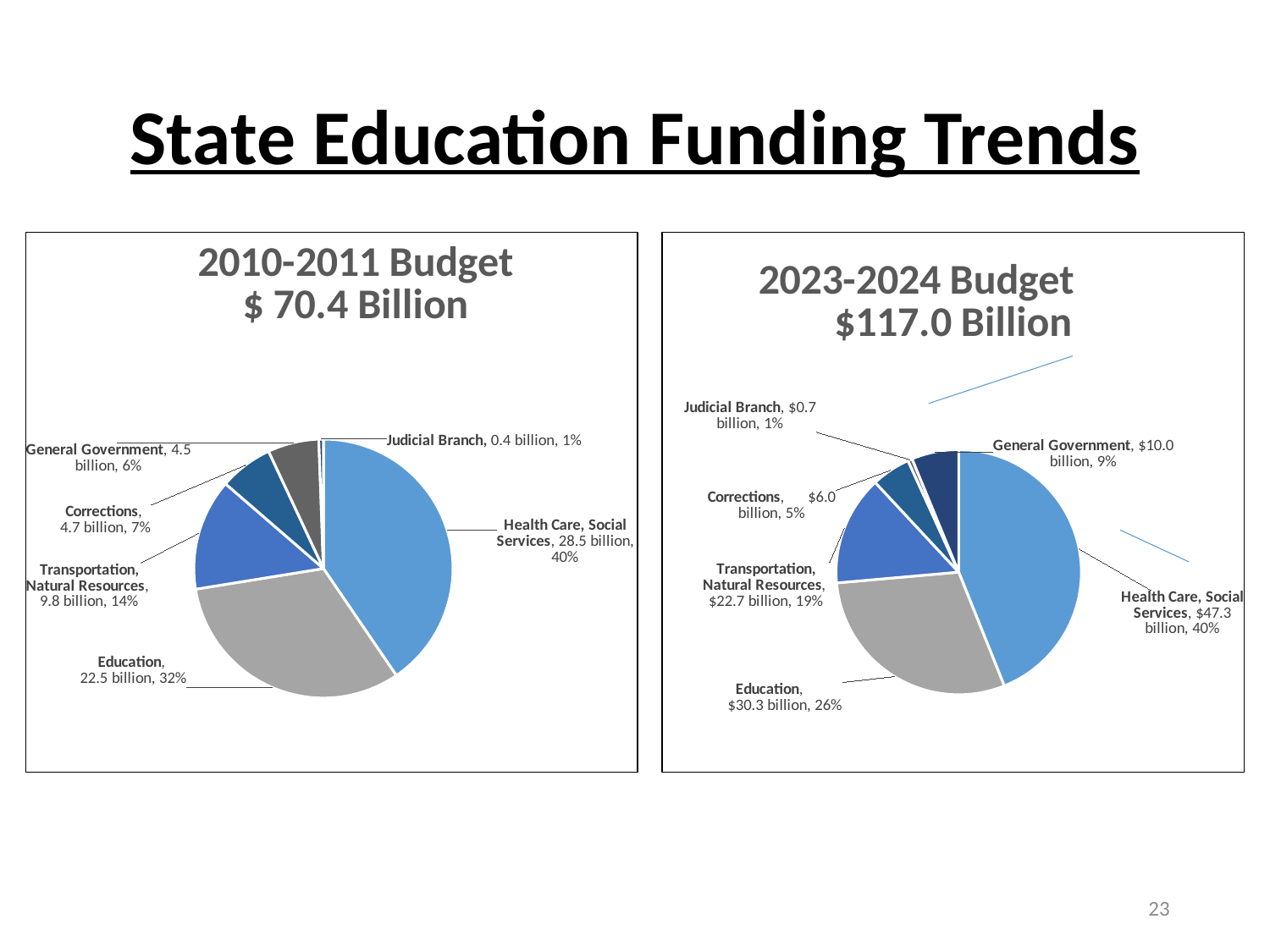
In the 2023-2024 Budget chart, which category has the smallest slice? Judicial Branch In the 2010-2011 Budget chart, which is larger, Corrections or General Government? Corrections In the 2023-2024 Budget chart, what is the difference between the Health Care, Social Services value and the Education value? $17.0 billion In the 2010-2011 Budget chart, which category has the largest slice? Health Care, Social Services In the 2023-2024 Budget chart, what value is shown for Education? $30.3 billion In the 2023-2024 Budget chart, what share of the pie does Health Care, Social Services take? 40% What total budget amount is stated in the title of the right-hand chart? $117.0 Billion In the 2023-2024 Budget chart, what value is shown for Corrections? $6.0 billion In the 2010-2011 Budget chart, what value is shown for Education? 22.5 billion How many slices does the 2023-2024 Budget pie chart have? 6 What type of chart is the 2010-2011 Budget chart? Pie chart In the 2010-2011 Budget chart, what share of the pie does Transportation, Natural Resources take? 14%